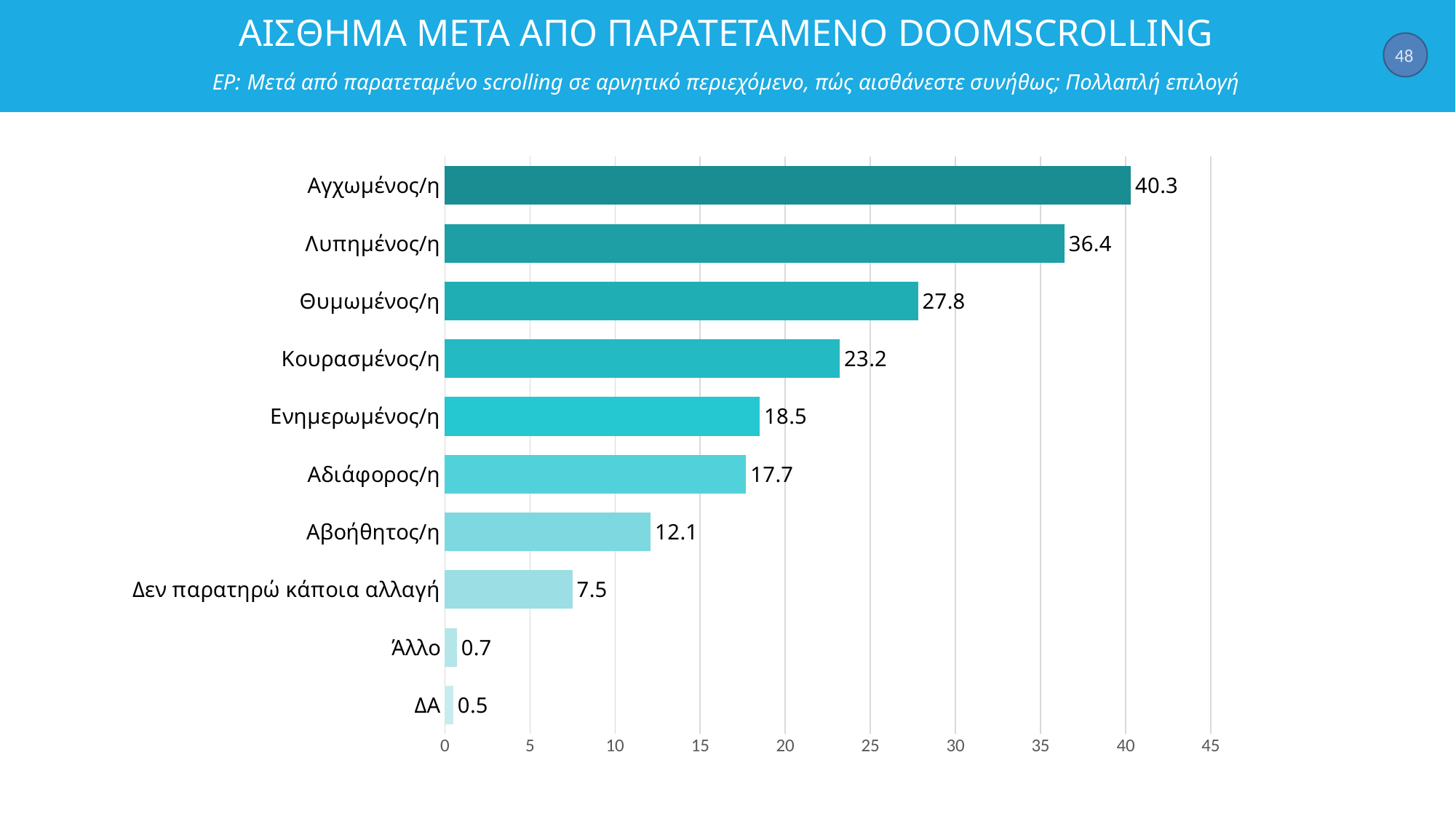
What is the value for Κουρασμένος/η? 23.2 What kind of chart is shown on the slide? bar chart Which category has the highest value? Αγχωμένος/η What is the value for Αγχωμένος/η? 40.3 What is the value for Δεν παρατηρώ κάποια αλλαγή? 7.5 What is the title of the chart on the slide? ΑΙΣΘΗΜΑ ΜΕΤΑ ΑΠΟ ΠΑΡΑΤΕΤΑΜΕΝΟ DOOMSCROLLING Which category has the lowest value? ΔΑ What is the difference between the values for Θυμωμένος/η and Αβοήθητος/η? 15.7 Is the value for Θυμωμένος/η greater or less than 25? greater What is the difference between the values for Αγχωμένος/η and Λυπημένος/η? 3.9 How many categories are shown in the chart? 10 Which is larger, the value for Ενημερωμένος/η or the value for Αδιάφορος/η? Ενημερωμένος/η